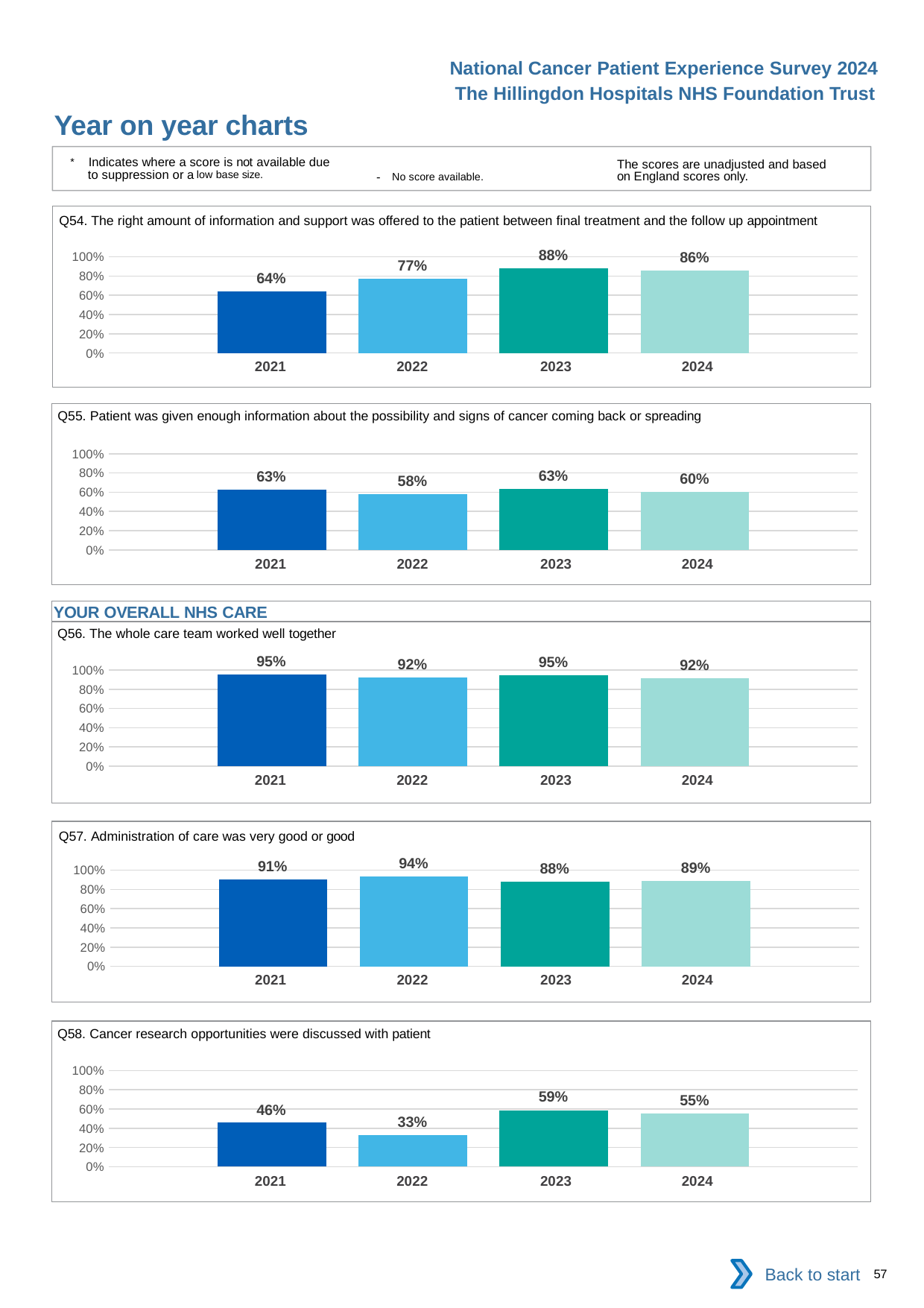
In the Q57 chart, which year has the highest value? 2022 In the Q55 chart, what is the difference between the 2023 and 2024 values? 3% In the Q56 chart, how many years are plotted? 4 In the Q57 chart, what is the difference between the 2021 and 2023 values? 3% What kind of chart is the Q54 chart? Bar chart In the Q54 chart, what is the value for 2023? 88% In the Q54 chart, which year has the lowest value? 2021 In the Q56 chart, what is the value for 2021? 95% In the Q58 chart, which is larger, the value for 2021 or the value for 2024? 2024 In the Q58 chart, is the value for 2023 greater or less than 40%? greater In the Q58 chart, what is the value for 2022? 33% In the Q55 chart, what is the value for 2022? 58%